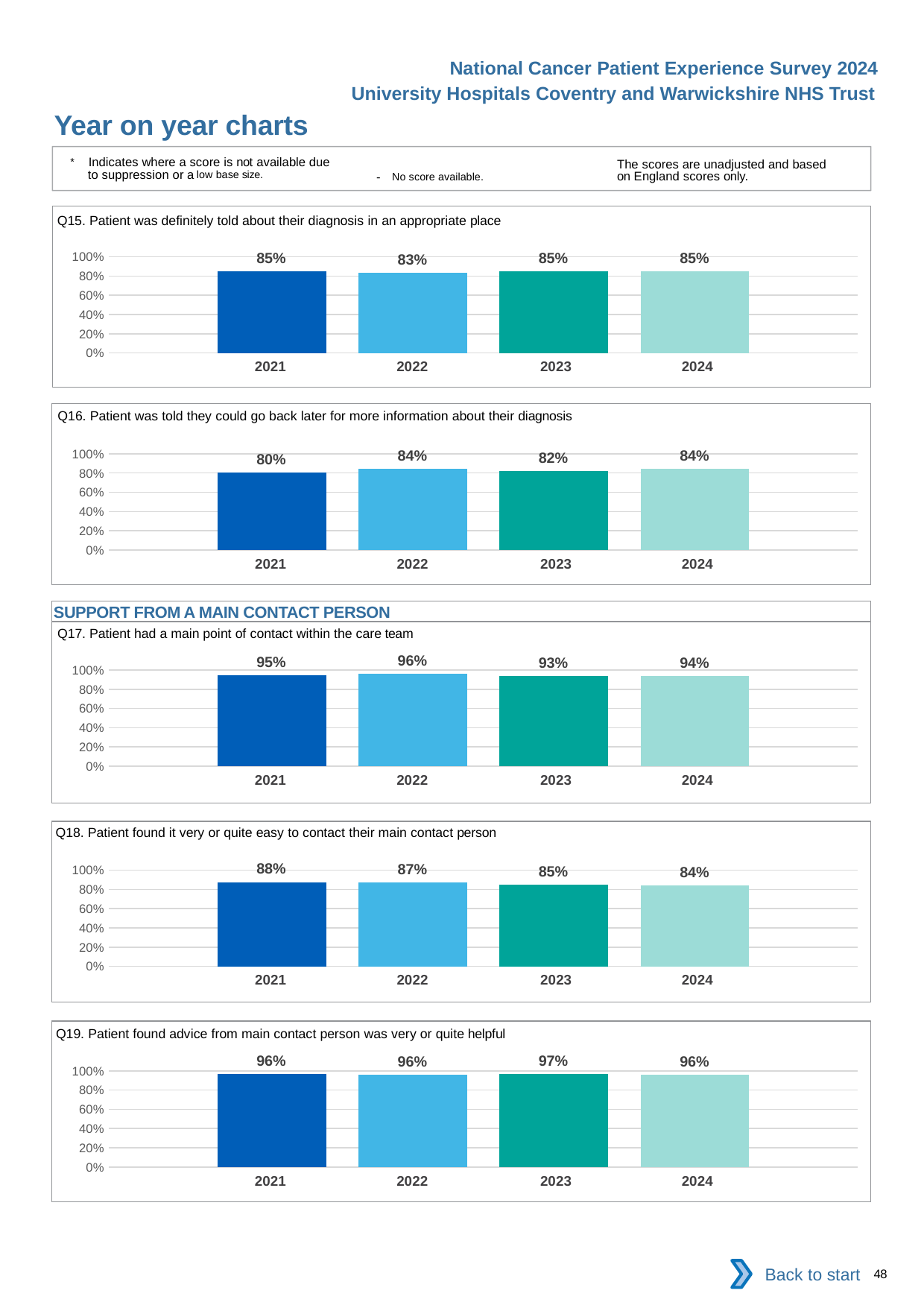
In the Q16 chart (Patient was told they could go back later for more information about their diagnosis), which year has the lowest value? 2021 In the Q19 chart (Patient found advice from main contact person was very or quite helpful), is the value for 2021 larger or smaller than the value for 2023? smaller In the Q16 chart (Patient was told they could go back later for more information about their diagnosis), what is the difference between the 2022 and 2021 values? 4 percentage points In the Q18 chart (Patient found it very or quite easy to contact their main contact person), do the values rise or fall from 2021 to 2024? fall In the Q17 chart (Patient had a main point of contact within the care team), which year has the highest value? 2022 In the Q17 chart (Patient had a main point of contact within the care team), what is the value for 2023? 93% What type of chart is the Q18 chart (Patient found it very or quite easy to contact their main contact person)? bar chart In the Q15 chart (Patient was definitely told about their diagnosis in an appropriate place), what is the value for 2022? 83% How many bars are plotted in the Q15 chart (Patient was definitely told about their diagnosis in an appropriate place)? 4 In the Q16 chart (Patient was told they could go back later for more information about their diagnosis), is the value for 2023 greater or less than 60%? greater In the Q19 chart (Patient found advice from main contact person was very or quite helpful), which year has the highest value? 2023 In the Q18 chart (Patient found it very or quite easy to contact their main contact person), what is the difference between the 2021 and 2024 values? 4 percentage points